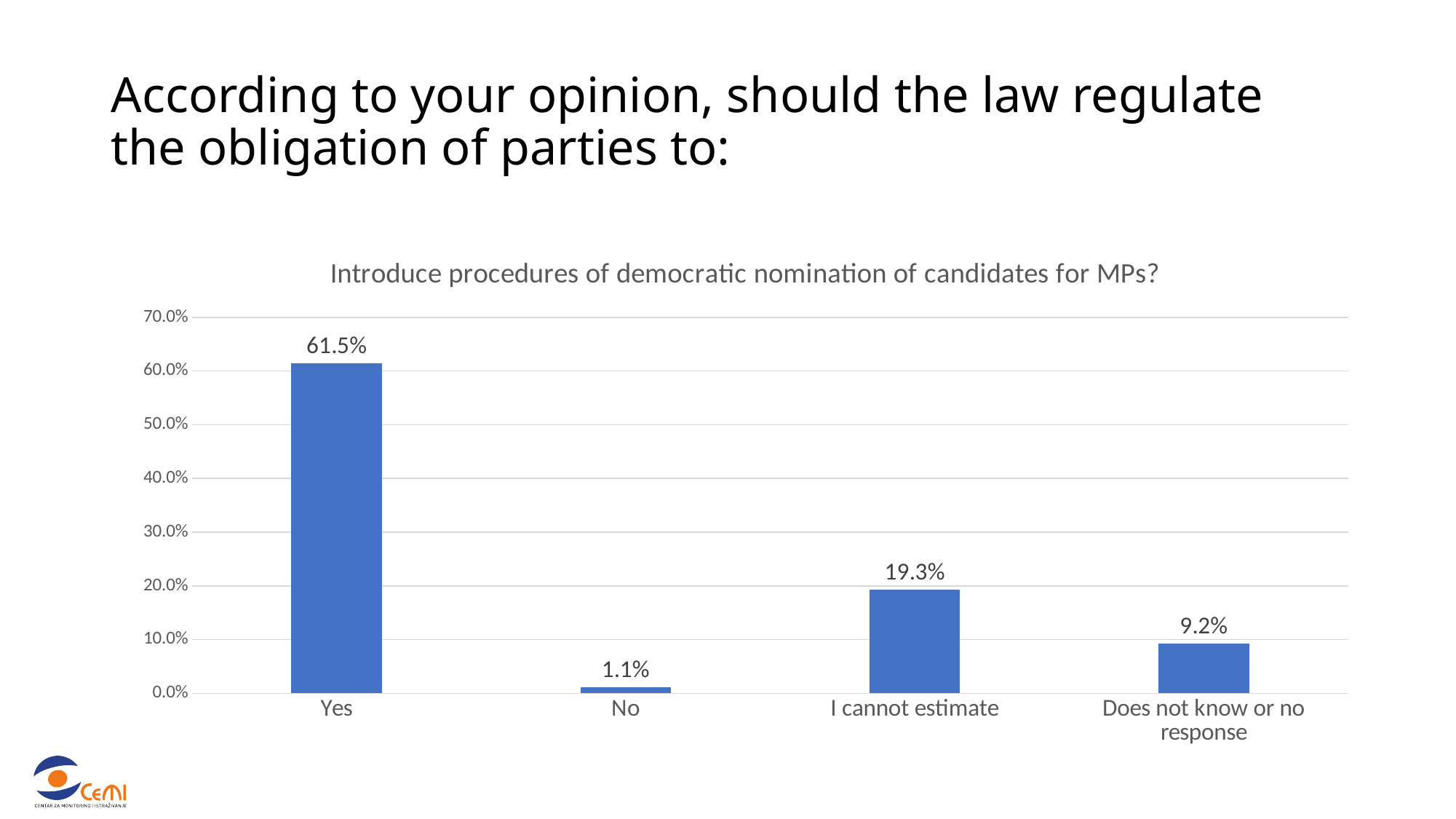
What is the value for "Does not know or no response"? 9.2% What is the difference between the values for "I cannot estimate" and "Does not know or no response"? 10.1% Which category has the lowest value? No What is the title of the chart? Introduce procedures of democratic nomination of candidates for MPs? How many categories are shown on the chart? 4 What is the value for "I cannot estimate"? 19.3% What is the value for "Yes"? 61.5% Which is larger, the value for "I cannot estimate" or the value for "Does not know or no response"? I cannot estimate What is the value for "No"? 1.1% Which category has the highest value? Yes What kind of chart is shown on the slide? Bar chart What is the difference between the values for "Yes" and "No"? 60.4%